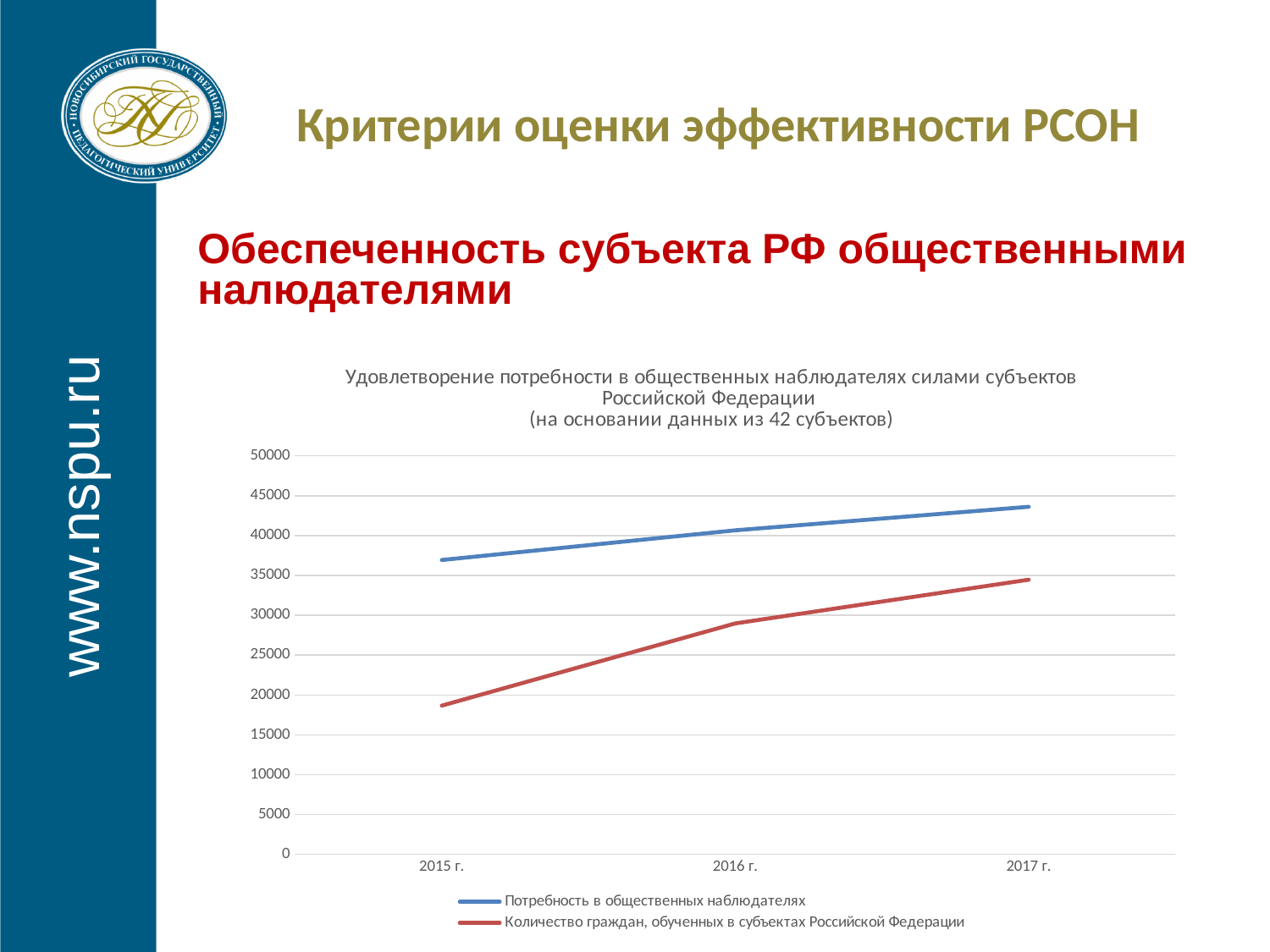
Is the value for "Потребность в общественных наблюдателях" in 2017 г. greater or less than 40000? greater Does the line for "Потребность в общественных наблюдателях" rise or fall from 2015 г. to 2017 г.? rise Which year has the lowest value for "Количество граждан, обученных в субъектах Российской Федерации"? 2015 г. Is the value for "Потребность в общественных наблюдателях" in 2015 г. greater or less than 35000? greater Is the value for "Количество граждан, обученных в субъектах Российской Федерации" in 2016 г. greater or less than 25000? greater Does the line for "Количество граждан, обученных в субъектах Российской Федерации" rise or fall from 2015 г. to 2017 г.? rise How many years are shown on the x axis of the chart? 3 What kind of chart is shown on the slide? line chart How many series does the chart legend list? 2 What colour is the line for "Количество граждан, обученных в субъектах Российской Федерации"? red In 2015 г., which series has the larger value: "Потребность в общественных наблюдателях" or "Количество граждан, обученных в субъектах Российской Федерации"? Потребность в общественных наблюдателях